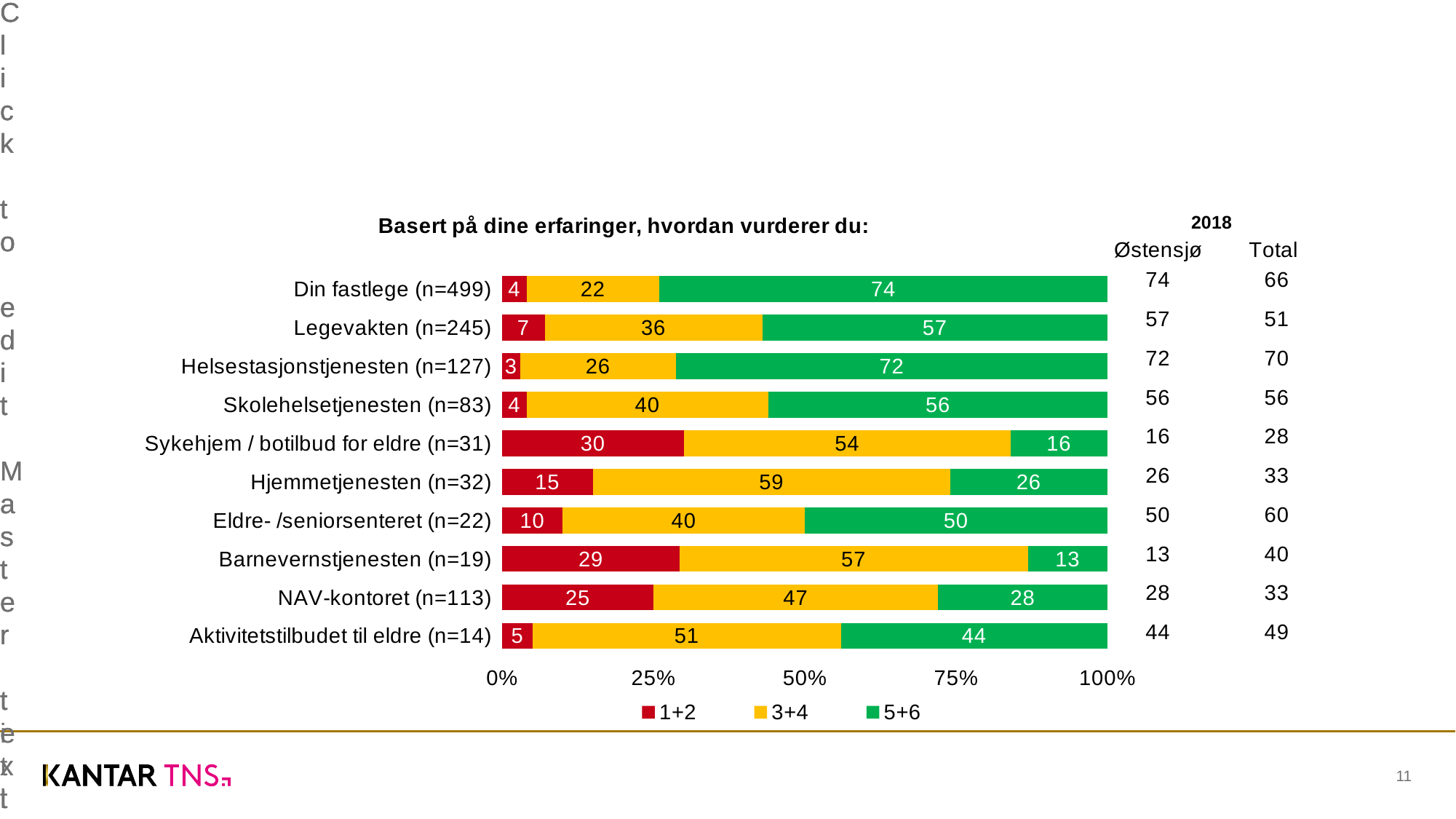
Which category has the lowest 5+6 value? Barnevernstjenesten (n=19) What is the 5+6 value for Din fastlege (n=499)? 74 Which has a larger 1+2 value, Barnevernstjenesten (n=19) or NAV-kontoret (n=113)? Barnevernstjenesten (n=19) How many categories are shown on the chart? 10 What is the total of the stacked bar for Eldre- /seniorsenteret (n=22)? 100 What is the title of the chart? Basert på dine erfaringer, hvordan vurderer du: Which category has the highest 5+6 value? Din fastlege (n=499) How many series does the legend list? 3 What is the difference between the 5+6 values for Legevakten (n=245) and NAV-kontoret (n=113)? 29 What is the 1+2 value for Sykehjem / botilbud for eldre (n=31)? 30 What kind of chart is shown? Stacked bar chart What is the 3+4 value for Hjemmetjenesten (n=32)? 59